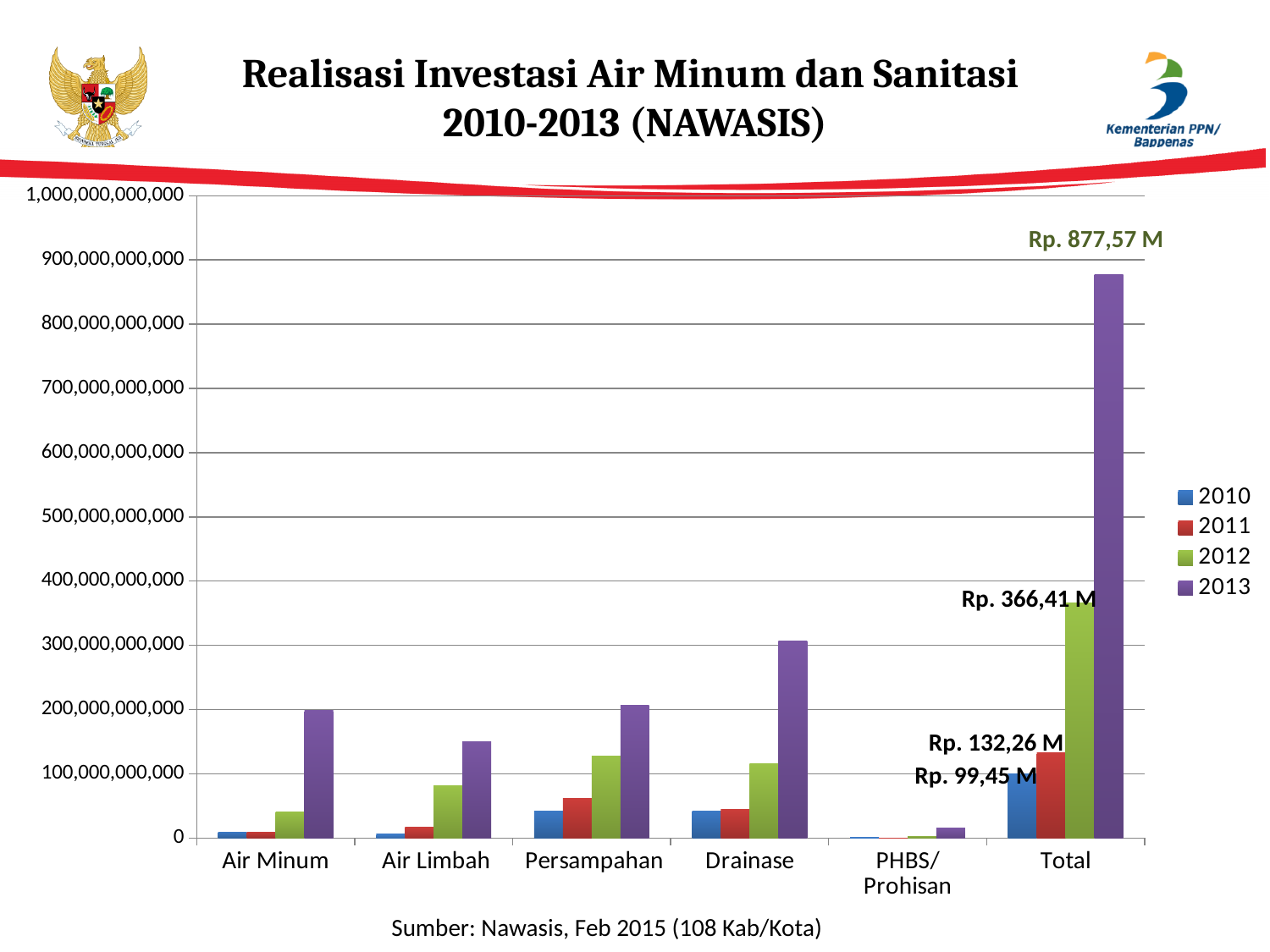
What is the labelled value for 2010 in the Total category? Rp. 99,45 M Which category has the lowest bars across all years? PHBS/Prohisan How many categories are shown on the x axis? 6 What is the difference between the 2011 and 2010 values in the Total category? Rp. 32,81 M What type of chart is shown on the slide? bar chart What is the difference between the 2013 and 2012 values in the Total category? Rp. 511,16 M How many series does the legend list? 4 What is the labelled value for 2012 in the Total category? Rp. 366,41 M Excluding the Total category, which category has the highest 2013 bar? Drainase Is the 2013 value for Air Limbah greater or less than 100,000,000,000? greater What is the labelled value for 2013 in the Total category? Rp. 877,57 M In the Total category, do the values rise or fall from 2010 to 2013? rise